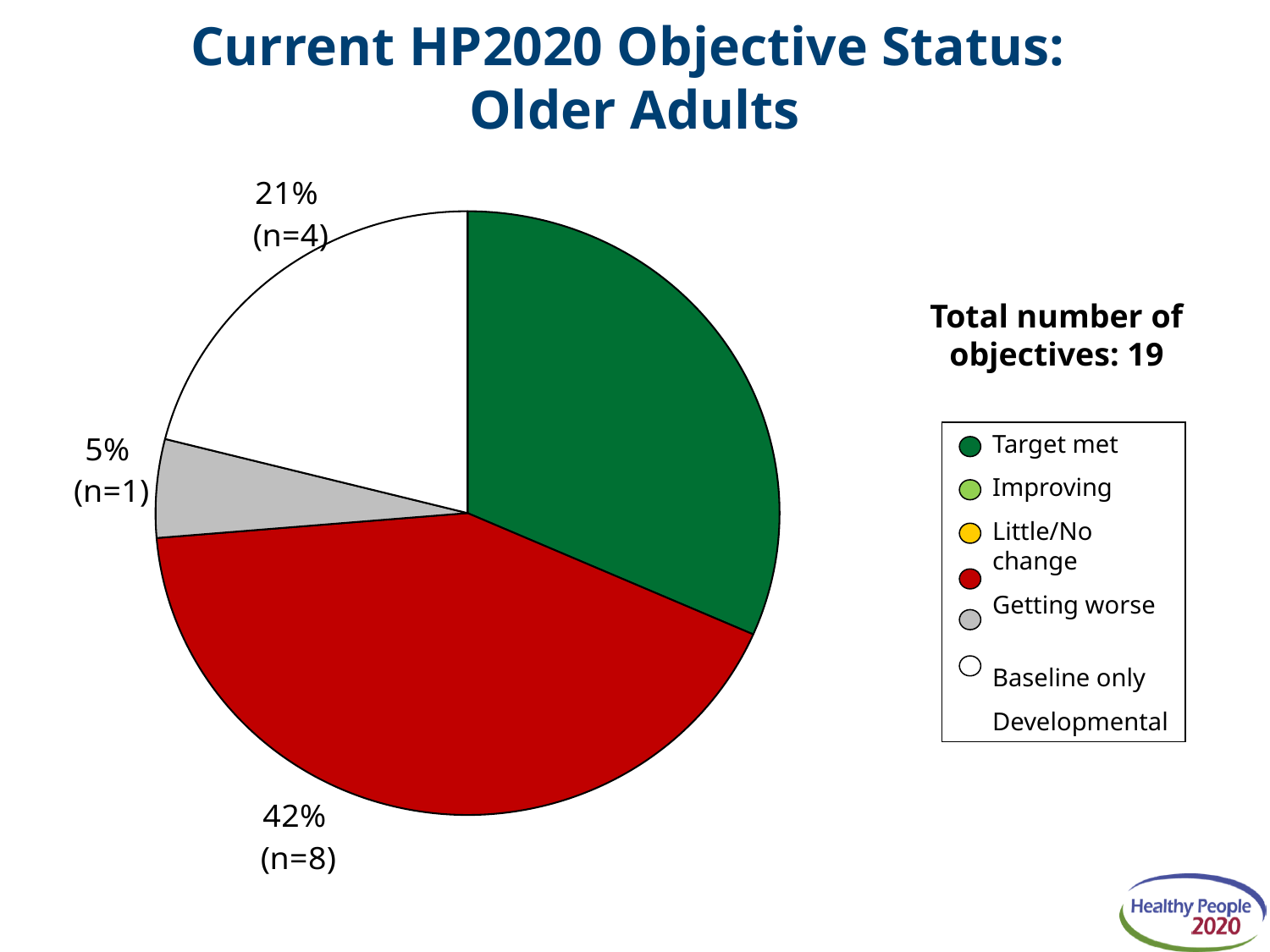
How many objectives (n) are in the Getting worse slice? 8 How many slices does the pie chart have? 4 What kind of chart is shown on the slide? Pie chart What percentage of objectives are Baseline only? 5% What percentage of objectives are in the Getting worse category? 42% Which category has the smallest slice of the pie? Baseline only Which category has the largest slice of the pie? Getting worse Which slice is larger, Developmental or Baseline only? Developmental What is the difference in percentage points between the Getting worse slice and the Developmental slice? 21 percentage points What percentage of objectives are Developmental? 21% How many objectives (n) are in the Developmental slice? 4 How many entries does the legend list? 6